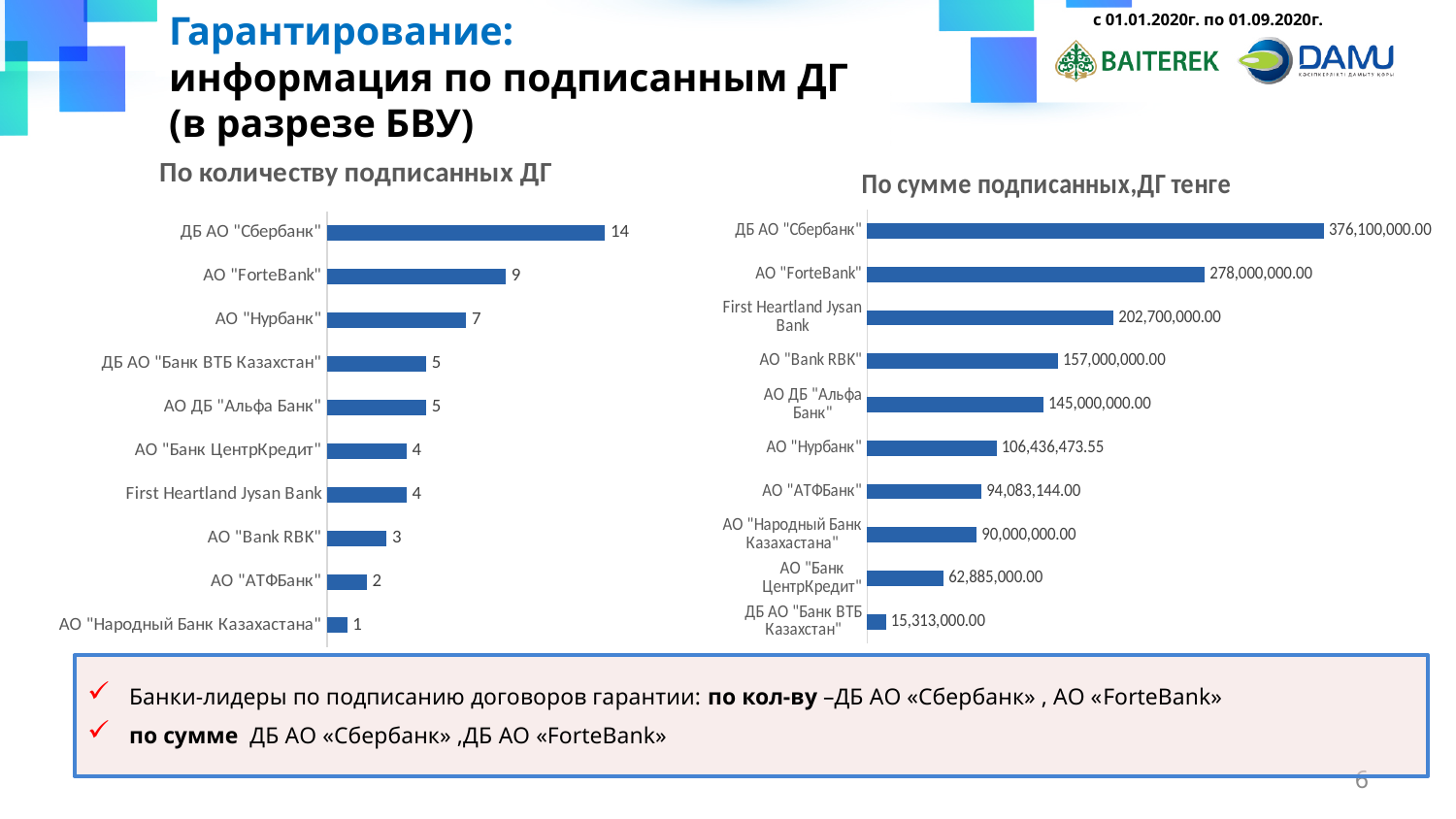
What type of chart is "По сумме подписанных,ДГ тенге"? Bar chart In the chart "По сумме подписанных,ДГ тенге", what is the value for ДБ АО "Банк ВТБ Казахстан"? 15,313,000.00 In the chart "По количеству подписанных ДГ", what is the difference between АО "ForteBank" and АО "Нурбанк"? 2 In the chart "По сумме подписанных,ДГ тенге", which is larger: АО "Bank RBK" or АО ДБ "Альфа Банк"? АО "Bank RBK" In the chart "По количеству подписанных ДГ", what is the value for АО "Bank RBK"? 3 In the chart "По сумме подписанных,ДГ тенге", what is the difference between ДБ АО "Сбербанк" and АО "ForteBank"? 98,100,000.00 In the chart "По количеству подписанных ДГ", what is the value for ДБ АО "Сбербанк"? 14 In the chart "По сумме подписанных,ДГ тенге", what is the value for АО "ForteBank"? 278,000,000.00 In the chart "По количеству подписанных ДГ", how many banks are shown? 10 In the chart "По сумме подписанных,ДГ тенге", what is the value for АО "Нурбанк"? 106,436,473.55 In the chart "По сумме подписанных,ДГ тенге", which bank has the highest value? ДБ АО "Сбербанк" In the chart "По количеству подписанных ДГ", which bank has the lowest value? АО "Народный Банк Казахастана"